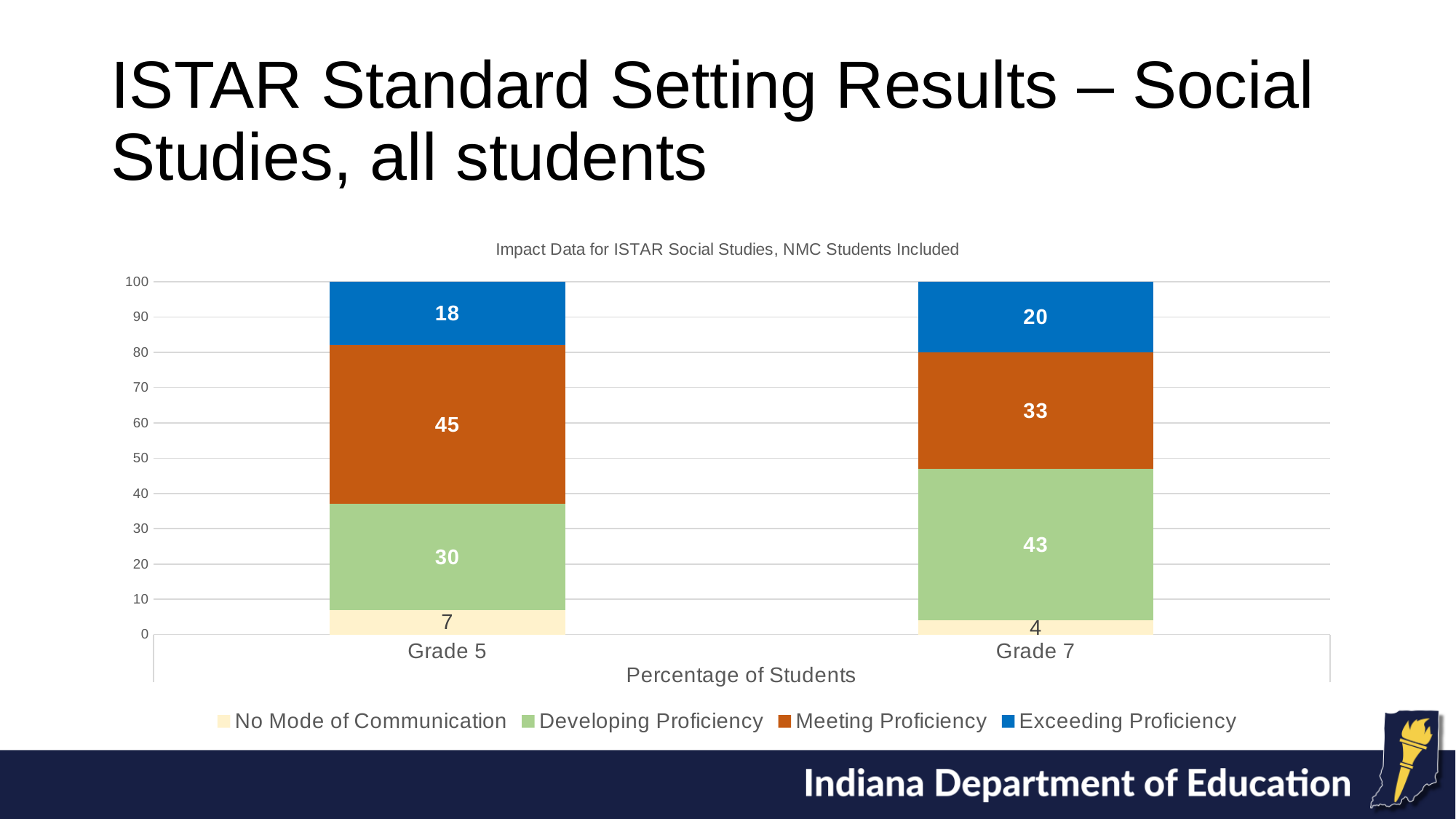
What type of chart is shown? Stacked bar chart How many grade categories are shown on the x axis? 2 What is the Developing Proficiency value for Grade 7? 43 How many series does the legend list? 4 What is the No Mode of Communication value for Grade 7? 4 What is the difference between the Developing Proficiency values for Grade 7 and Grade 5? 13 What is the Exceeding Proficiency value for Grade 5? 18 Which series has the largest value for Grade 7? Developing Proficiency What is the total of the stacked bar for Grade 5? 100 Which grade has the higher Meeting Proficiency value? Grade 5 What is the Meeting Proficiency value for Grade 5? 45 Which series has the smallest value for Grade 5? No Mode of Communication